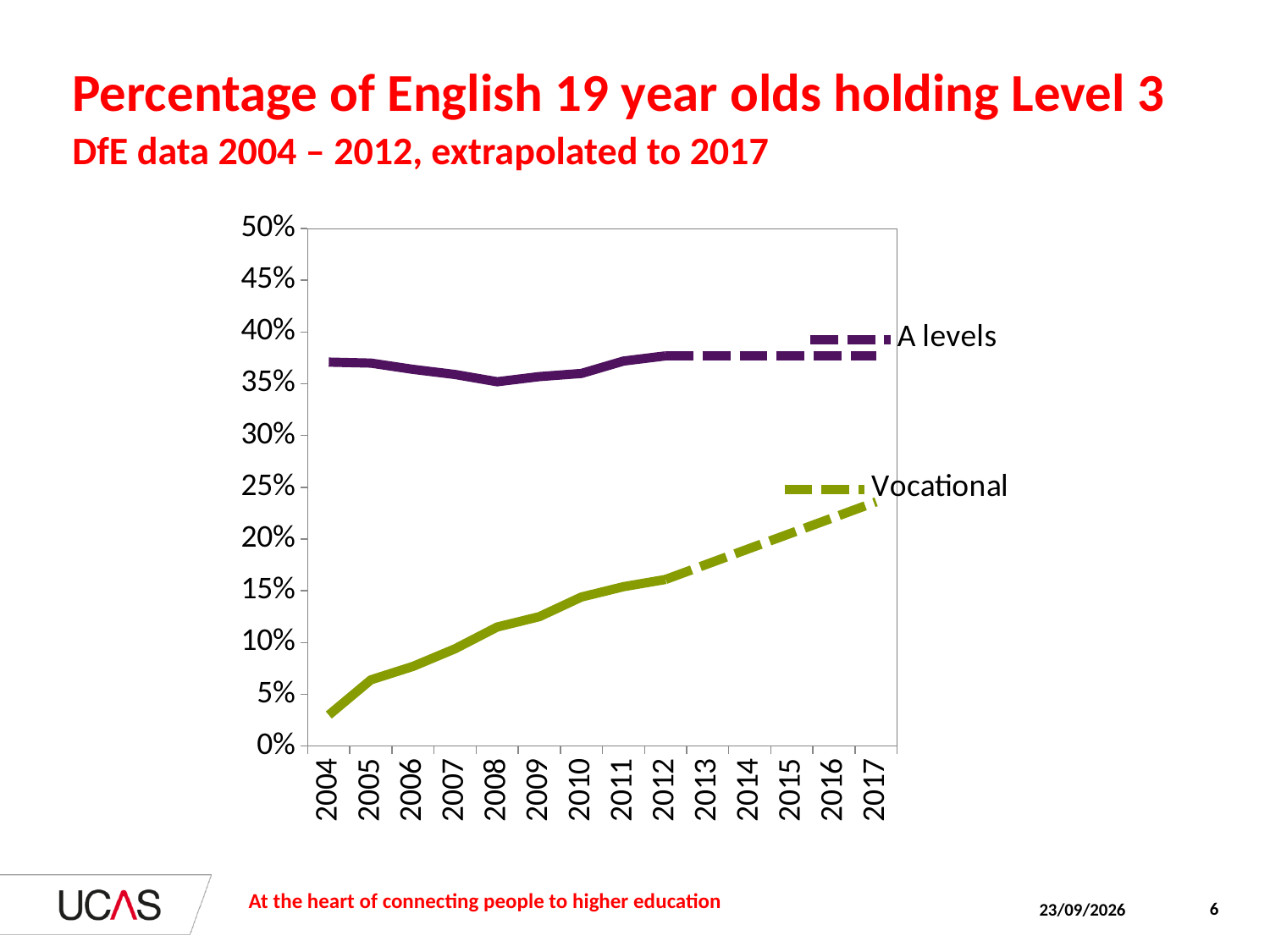
In which year is the Vocational value lowest? 2004 Is the Vocational value for 2017 greater or less than 20%? greater Is the A levels value for 2008 greater or less than 30%? greater Which series has the larger value in 2010, A levels or Vocational? A levels Does the Vocational line rise or fall from 2004 to 2017? rise In which year is the Vocational value highest? 2017 Is the Vocational value for 2004 greater or less than 5%? less What are the two series plotted on the chart? A levels and Vocational How many series does the chart show? 2 What kind of chart is shown on the slide? line chart How many years are shown along the x axis? 14